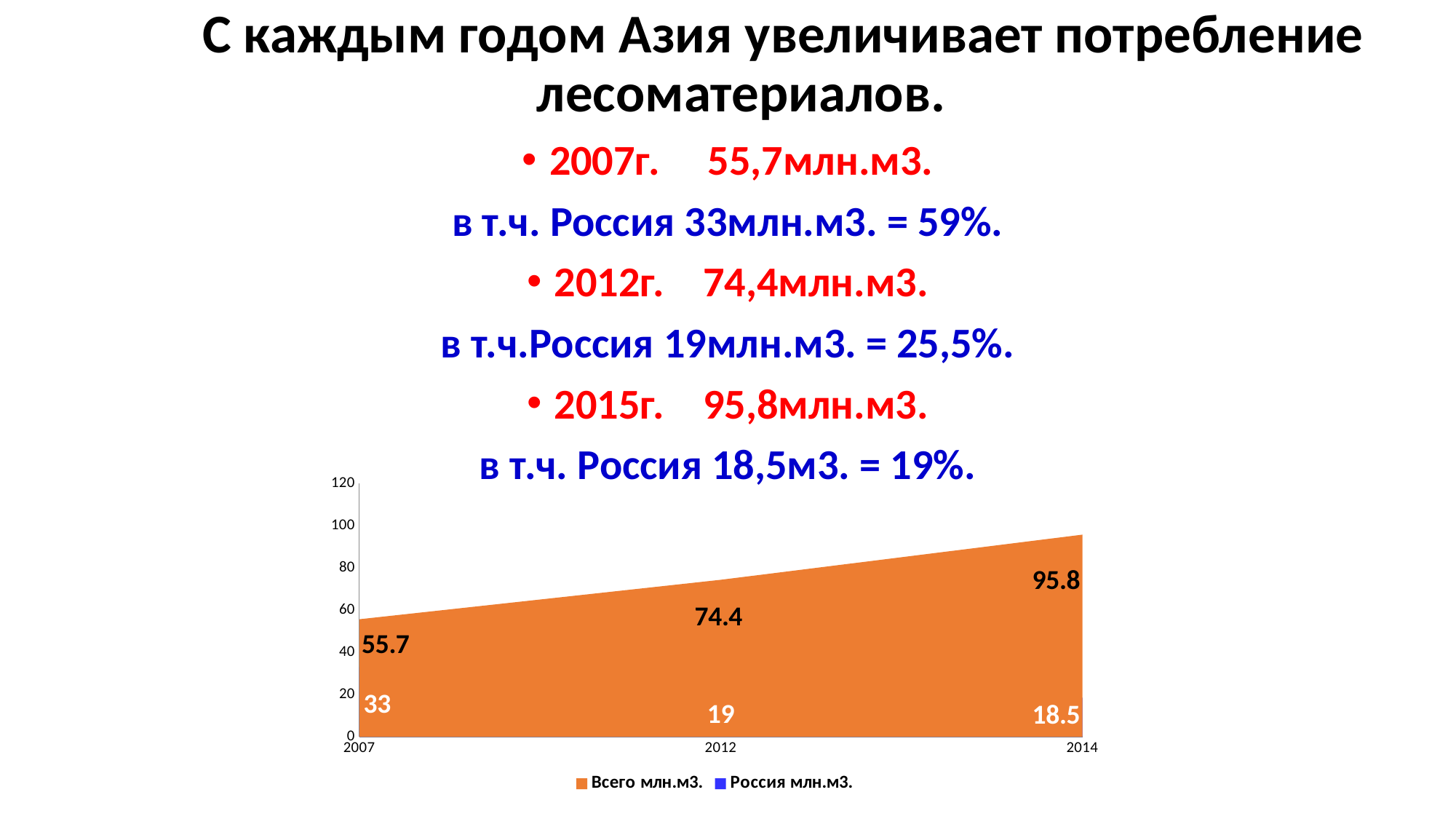
How many series does the chart legend list? 2 What is the value of the 'Всего млн.м3.' series for 2014? 95.8 What is the value of the 'Россия млн.м3.' series for 2007? 33 In which year is the 'Россия млн.м3.' series lowest? 2014 What is the value of the 'Россия млн.м3.' series for 2014? 18.5 What is the difference between the 'Всего млн.м3.' values for 2014 and 2007? 40.1 What is the value of the 'Всего млн.м3.' series for 2012? 74.4 Which is larger: the 'Россия млн.м3.' value for 2007 or for 2012? 2007 How many years are shown on the x axis of the chart? 3 In which year is the 'Всего млн.м3.' series highest? 2014 What kind of chart is shown on the slide? Area chart Does the 'Всего млн.м3.' series rise or fall from 2007 to 2014? Rises